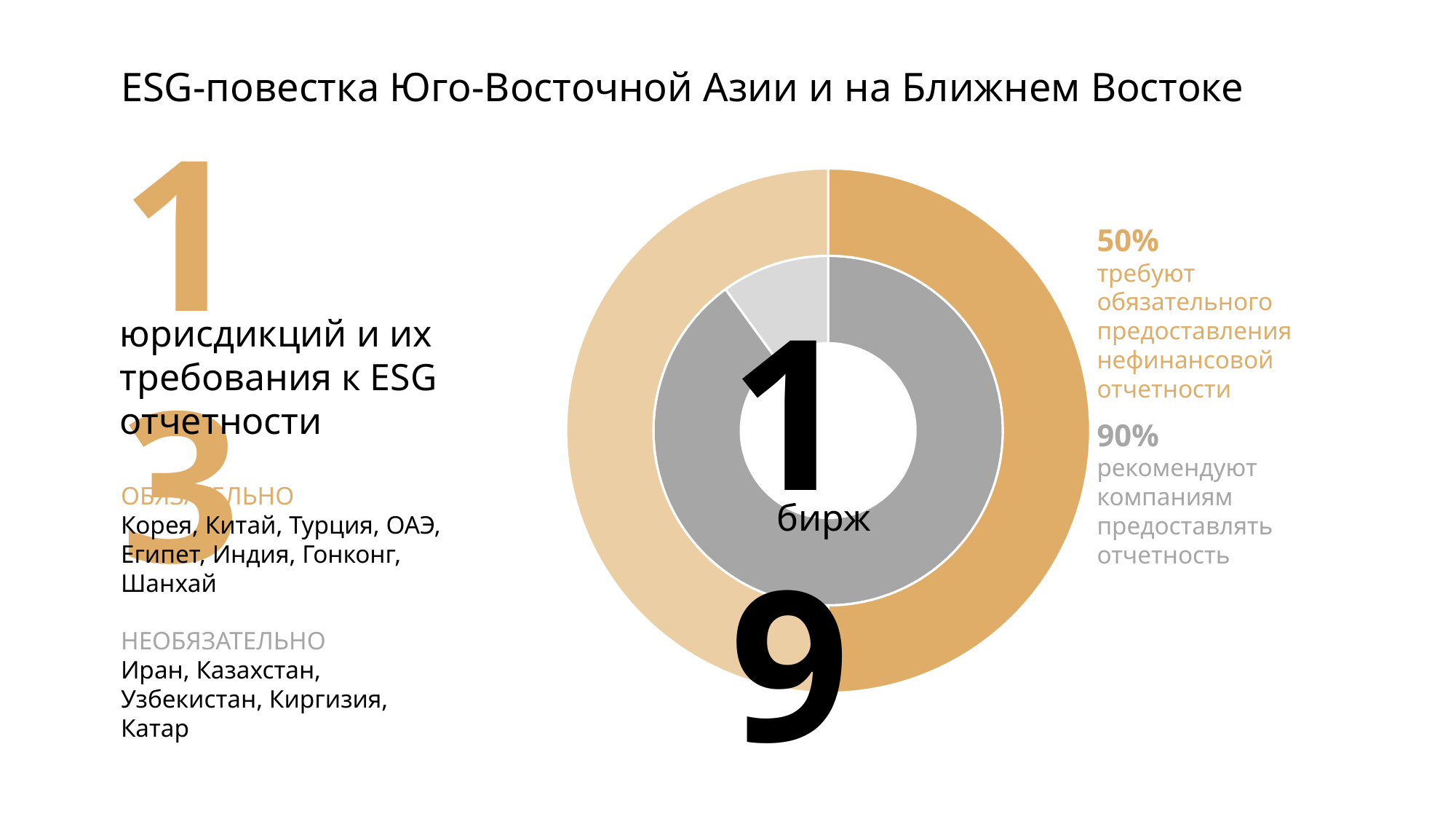
What is the difference between the share of exchanges that recommend reporting and the share that require mandatory reporting? 40% Which share is larger: exchanges that require mandatory reporting or exchanges that recommend reporting? Exchanges that recommend reporting (90%) What share of the outer ring is not covered by the 50% segment? 50% What number is printed in the centre of the doughnut chart? 19 бирж Which ring of the doughnut chart contains the orange 50% segment, the outer or the inner? Outer What share of the inner ring is not covered by the 90% segment? 10% Is the share of exchanges that recommend reporting greater or less than 50%? greater What percentage of exchanges recommend that companies provide reporting (рекомендуют компаниям предоставлять отчетность)? 90% How many rings does the doughnut chart have? 2 What percentage of exchanges require mandatory provision of non-financial reporting (требуют обязательного предоставления нефинансовой отчетности)? 50% What kind of chart is shown in the centre of the slide? Doughnut (pie) chart